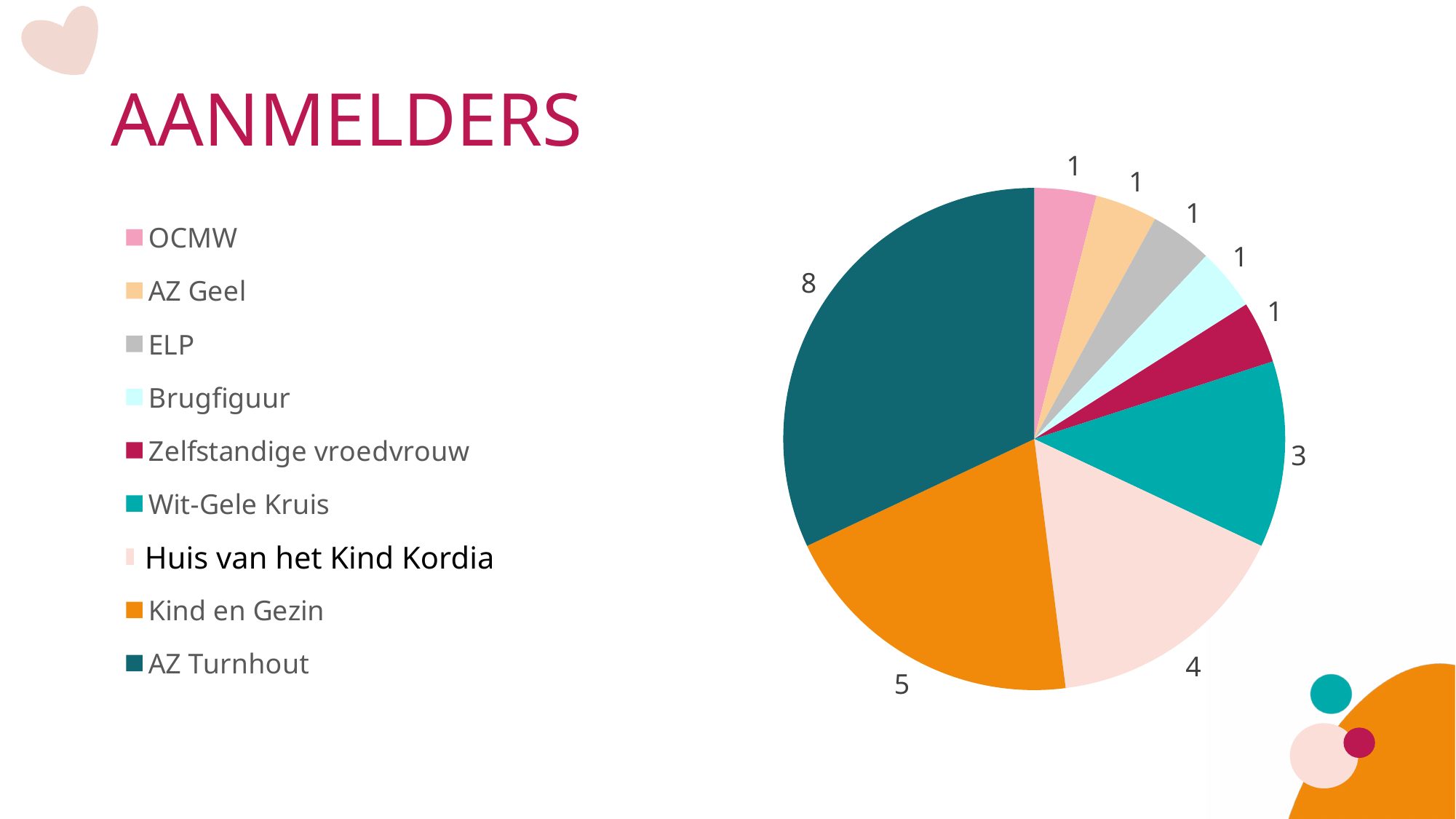
What is the title of the slide containing the pie chart? AANMELDERS What is the difference between the values for AZ Turnhout and Kind en Gezin? 3 What share of the pie does AZ Turnhout represent? 32% What type of chart is shown on the slide? Pie chart What is the value for Wit-Gele Kruis? 3 What is the value for Kind en Gezin? 5 Which is larger, the value for Wit-Gele Kruis or the value for Huis van het Kind Kordia? Huis van het Kind Kordia How many slices does the pie chart have? 9 Which category has the largest slice of the pie? AZ Turnhout What is the value for Huis van het Kind Kordia? 4 What is the value for AZ Turnhout? 8 What share of the pie does Kind en Gezin represent? 20%